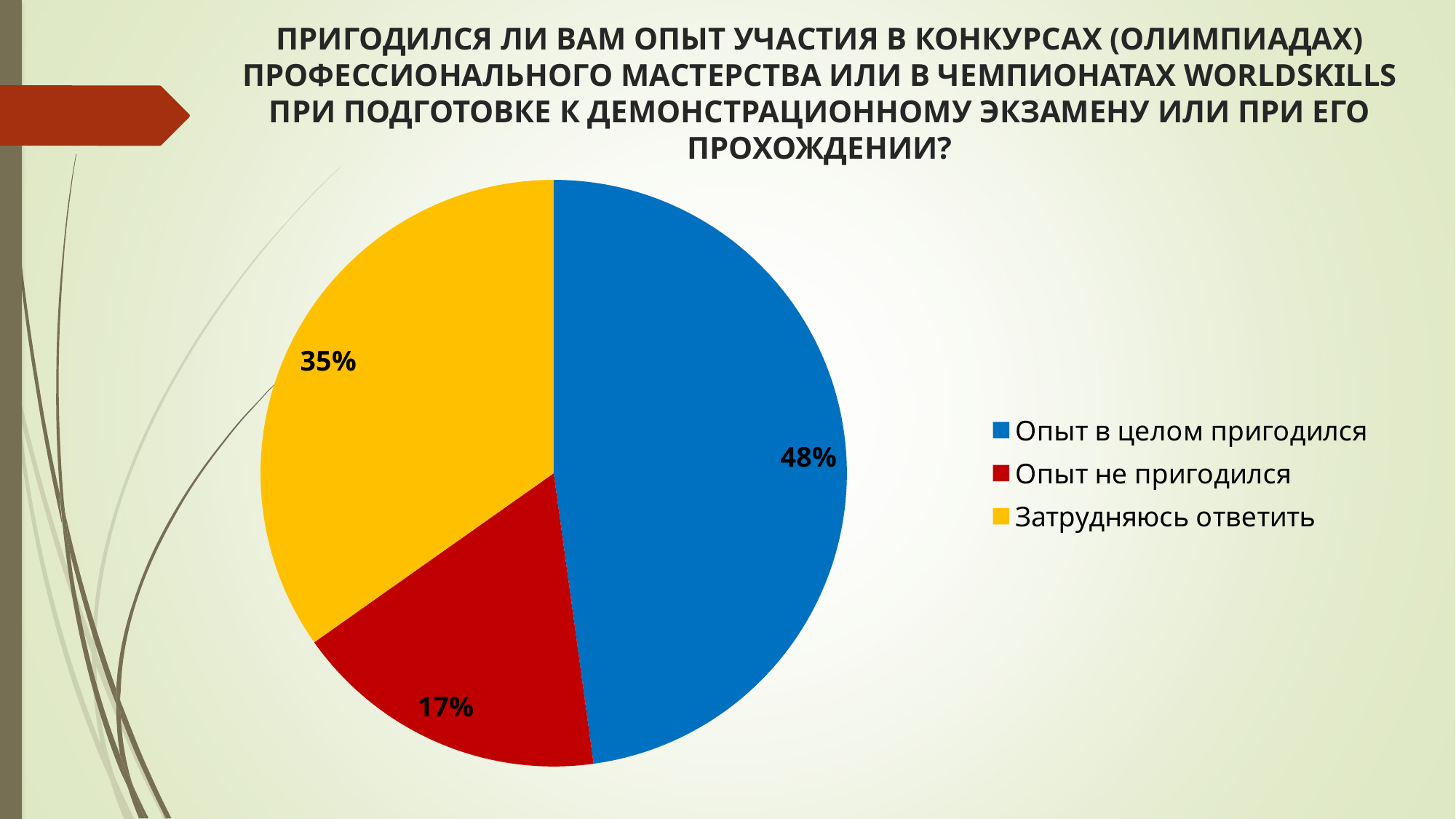
What share of respondents answered "Опыт в целом пригодился"? 48% Which answer option has the largest share of the pie? Опыт в целом пригодился Which answer option has the smallest share of the pie? Опыт не пригодился What type of chart is shown on the slide? pie chart What is the difference in percentage points between "Опыт в целом пригодился" and "Опыт не пригодился"? 31 What share of respondents answered "Опыт не пригодился"? 17% How many entries does the legend list? 3 What is the difference in percentage points between "Затрудняюсь ответить" and "Опыт не пригодился"? 18 Which is larger: the share for "Затрудняюсь ответить" or the share for "Опыт не пригодился"? Затрудняюсь ответить What colour is the slice for "Опыт не пригодился"? red How many slices does the pie chart have? 3 What share of respondents answered "Затрудняюсь ответить"? 35%